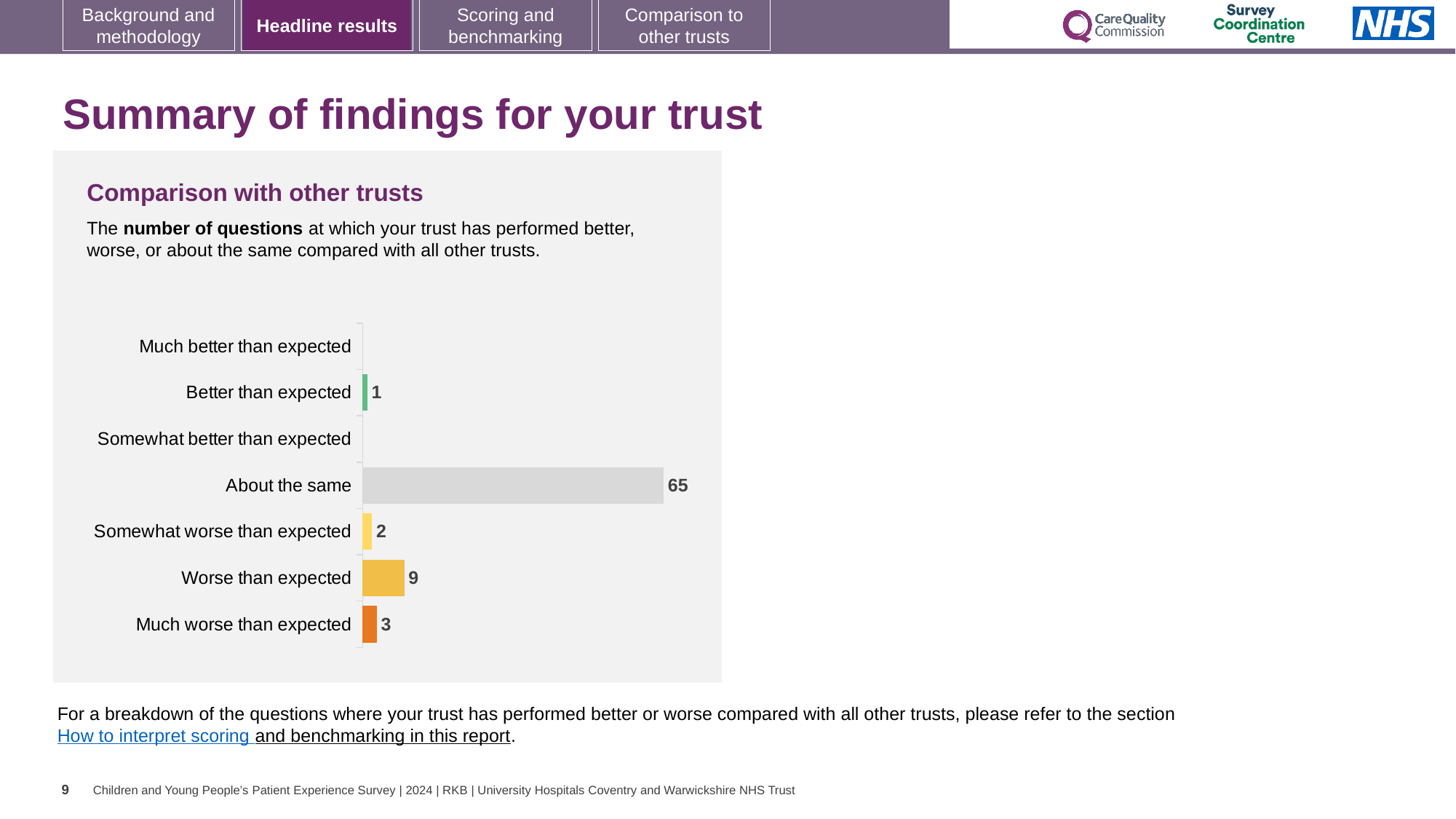
How many questions were rated 'Worse than expected'? 9 What is the difference between the number of questions rated 'About the same' and 'Worse than expected'? 56 Which category has the highest number of questions? About the same How many questions were rated 'Somewhat worse than expected'? 2 Which is larger: the number of questions rated 'Worse than expected' or 'Somewhat worse than expected'? Worse than expected What kind of chart is shown under 'Comparison with other trusts'? Bar chart How many categories are listed on the chart's vertical axis? 7 What colour is the bar for 'Much worse than expected'? Orange What is the difference between the number of questions rated 'Worse than expected' and 'Much worse than expected'? 6 How many questions were rated 'Much worse than expected'? 3 How many questions were rated 'Better than expected'? 1 How many questions were rated 'About the same'? 65